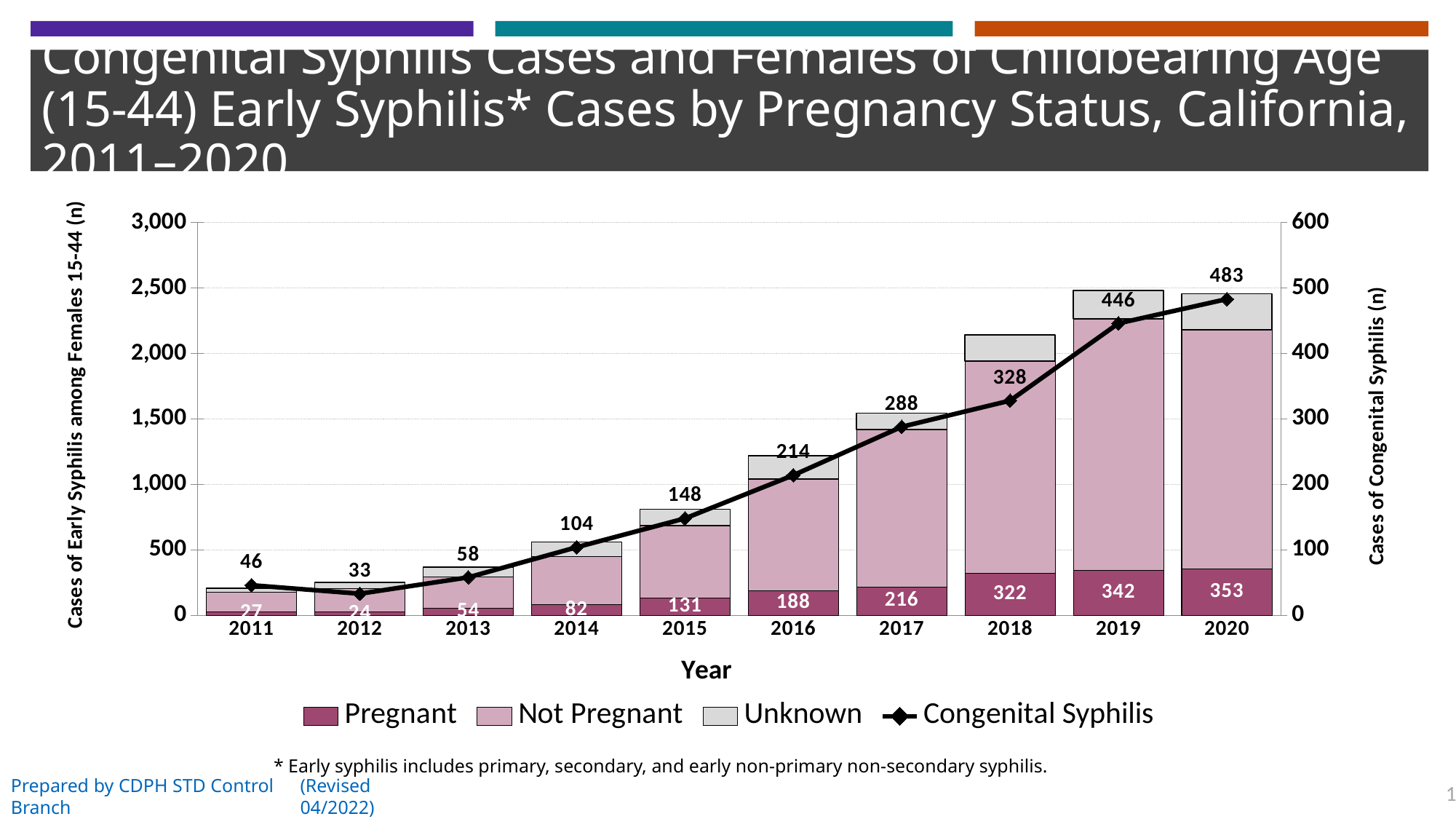
Which year has the highest value for the Pregnant series? 2020 What is the number of Congenital Syphilis cases in 2014? 104 Which year has the lowest number of Congenital Syphilis cases? 2012 Does the Congenital Syphilis line generally rise or fall from 2012 to 2020? rise What is the value of the Pregnant series in 2018? 322 What is the difference between the Pregnant values for 2017 and 2016? 28 How many years are shown on the x axis? 10 What is the difference in Congenital Syphilis cases between 2019 and 2018? 118 Is the total height of the stacked bar for 2018 greater or less than 2,000 on the left axis? greater How many series does the legend list? 4 What is the number of Congenital Syphilis cases in 2020? 483 Which is larger, the Pregnant value in 2015 or the Congenital Syphilis value in 2015? Congenital Syphilis in 2015 (148)